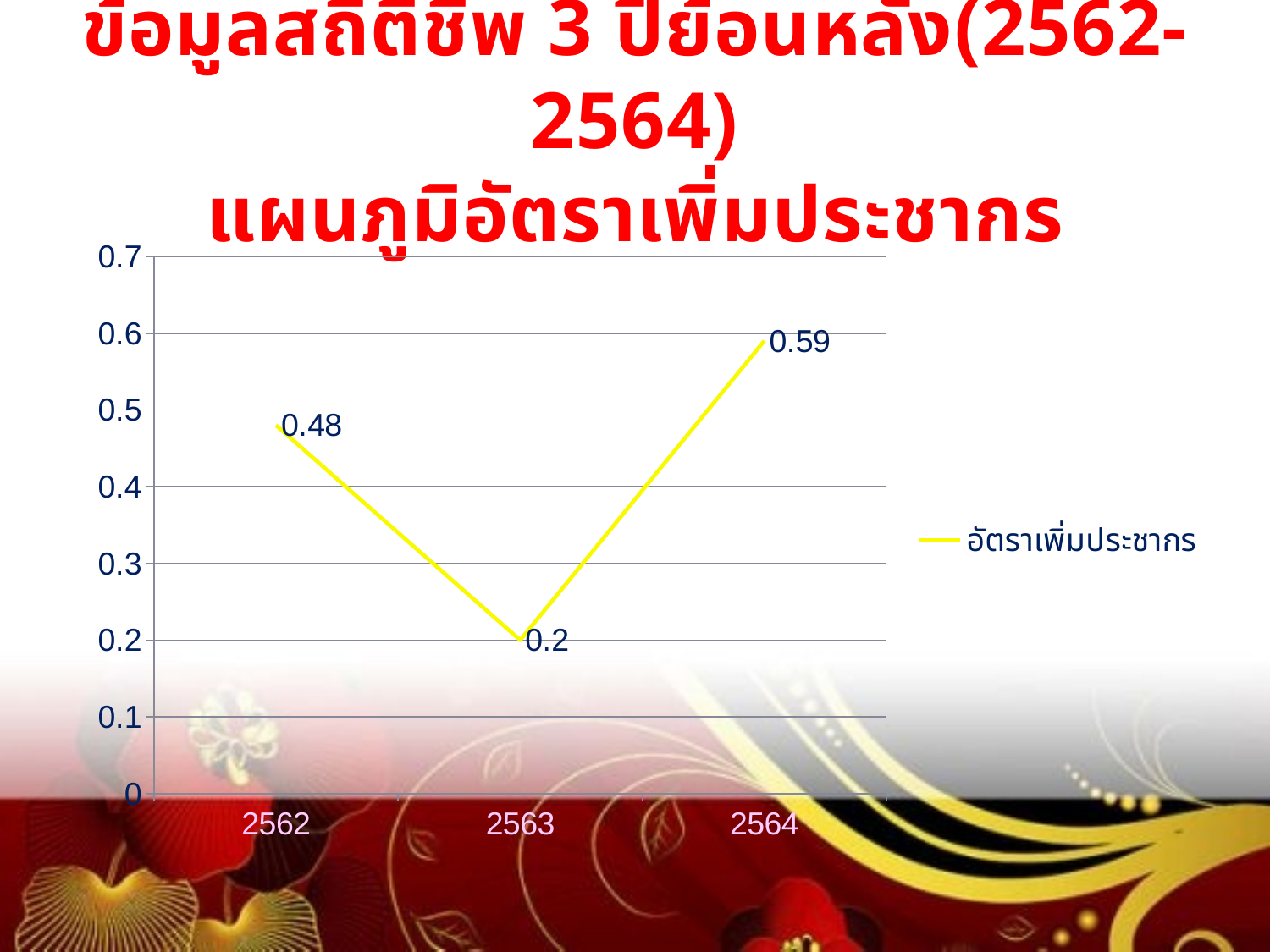
What is the value for 2563? 0.2 What is the value for 2564? 0.59 Is the value for 2564 greater or less than 0.5? greater Which year has the highest value? 2564 How many years are plotted on the x axis? 3 What is the value for 2562? 0.48 Which year has the lowest value? 2563 What is the difference between the values for 2564 and 2562? 0.11 What kind of chart is shown? line chart What is the difference between the values for 2564 and 2563? 0.39 How many series does the legend list? 1 Which is larger, the value for 2562 or the value for 2563? 2562